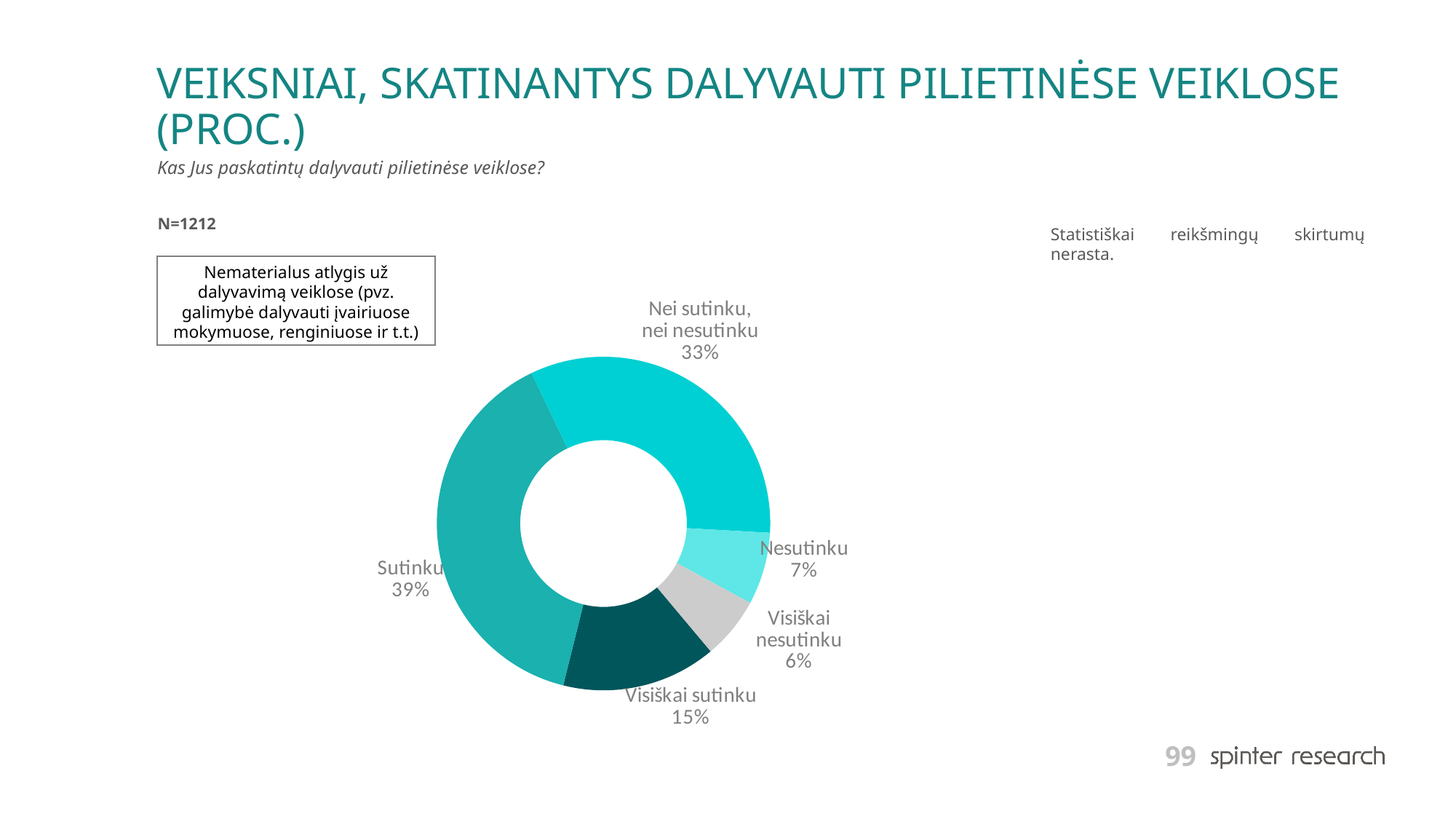
What is the difference in percentage points between "Sutinku" and "Visiškai sutinku"? 24 What percentage of respondents answered "Visiškai sutinku"? 15% Which response category has the smallest share of the chart? Visiškai nesutinku What percentage of respondents answered "Nei sutinku, nei nesutinku"? 33% How many response categories are shown in the chart? 5 What percentage of respondents answered "Sutinku"? 39% What is the sample size (N) stated on the slide? N=1212 What kind of chart is shown on the slide? Doughnut (pie) chart Which response category has the largest share of the chart? Sutinku What percentage of respondents answered "Nesutinku"? 7% What percentage of respondents answered "Visiškai nesutinku"? 6% Which is larger, the share for "Nei sutinku, nei nesutinku" or the share for "Visiškai sutinku"? Nei sutinku, nei nesutinku